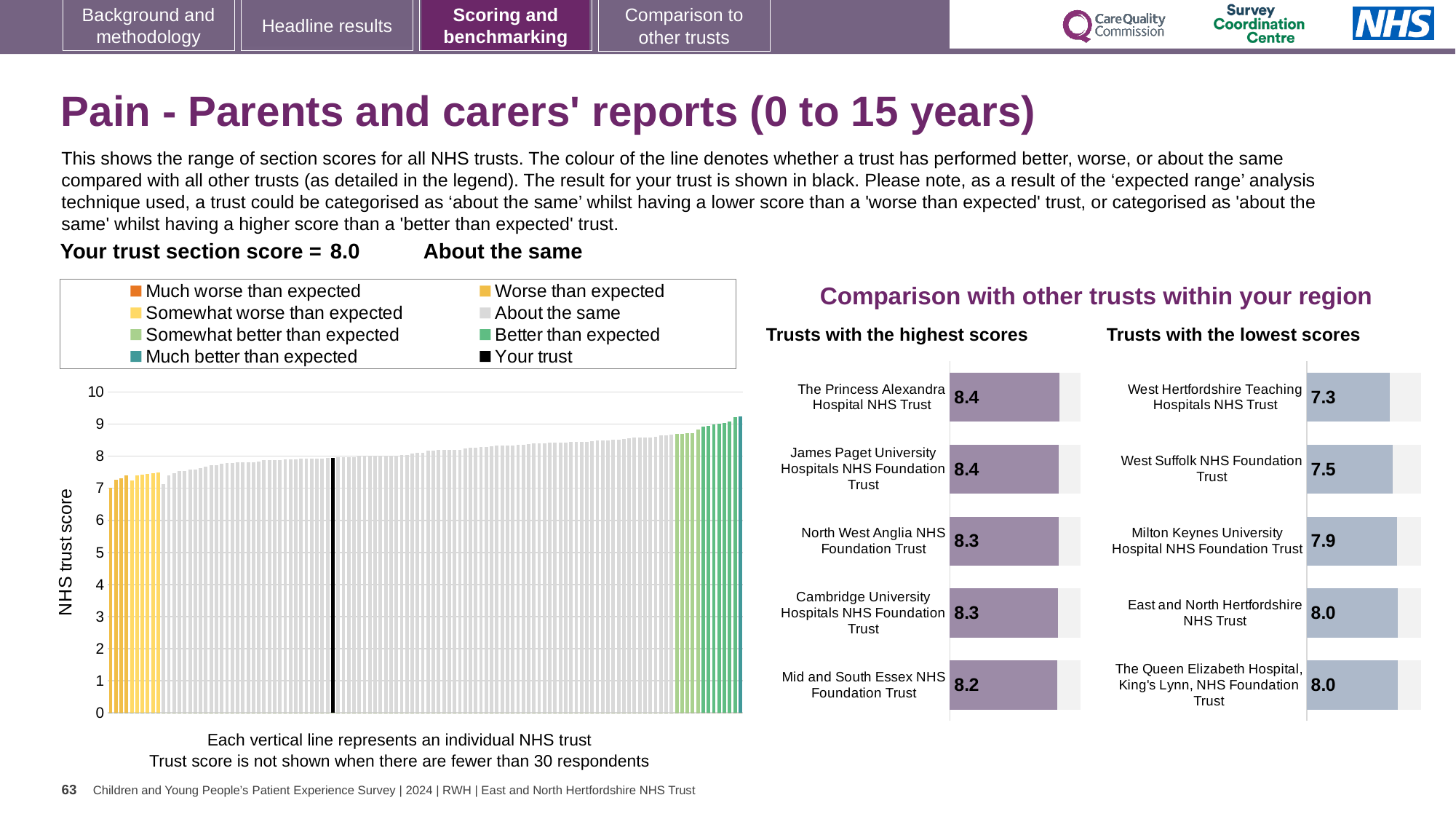
In the 'Trusts with the lowest scores' chart, which has the higher score: Milton Keynes University Hospital NHS Foundation Trust or West Suffolk NHS Foundation Trust? Milton Keynes University Hospital NHS Foundation Trust In the large chart on the left, do the trust scores rise or fall from left to right along the x axis? Rise In the 'Trusts with the lowest scores' chart, what is the score for Milton Keynes University Hospital NHS Foundation Trust? 7.9 In the 'Trusts with the highest scores' chart, what is the score for The Princess Alexandra Hospital NHS Trust? 8.4 In the 'Trusts with the lowest scores' chart, what is the score for West Hertfordshire Teaching Hospitals NHS Trust? 7.3 In the 'Trusts with the lowest scores' chart, which trust has the lowest score? West Hertfordshire Teaching Hospitals NHS Trust What type of chart is the large chart on the left showing NHS trust scores? Bar chart In the 'Trusts with the lowest scores' chart, what is the difference between the scores of West Suffolk NHS Foundation Trust and West Hertfordshire Teaching Hospitals NHS Trust? 0.2 How many trusts are listed in the 'Trusts with the highest scores' chart? 5 How many entries does the legend of the large chart on the left list? 8 In the 'Trusts with the highest scores' chart, which trust has the lowest score shown? Mid and South Essex NHS Foundation Trust In the 'Trusts with the highest scores' chart, what is the score for Mid and South Essex NHS Foundation Trust? 8.2